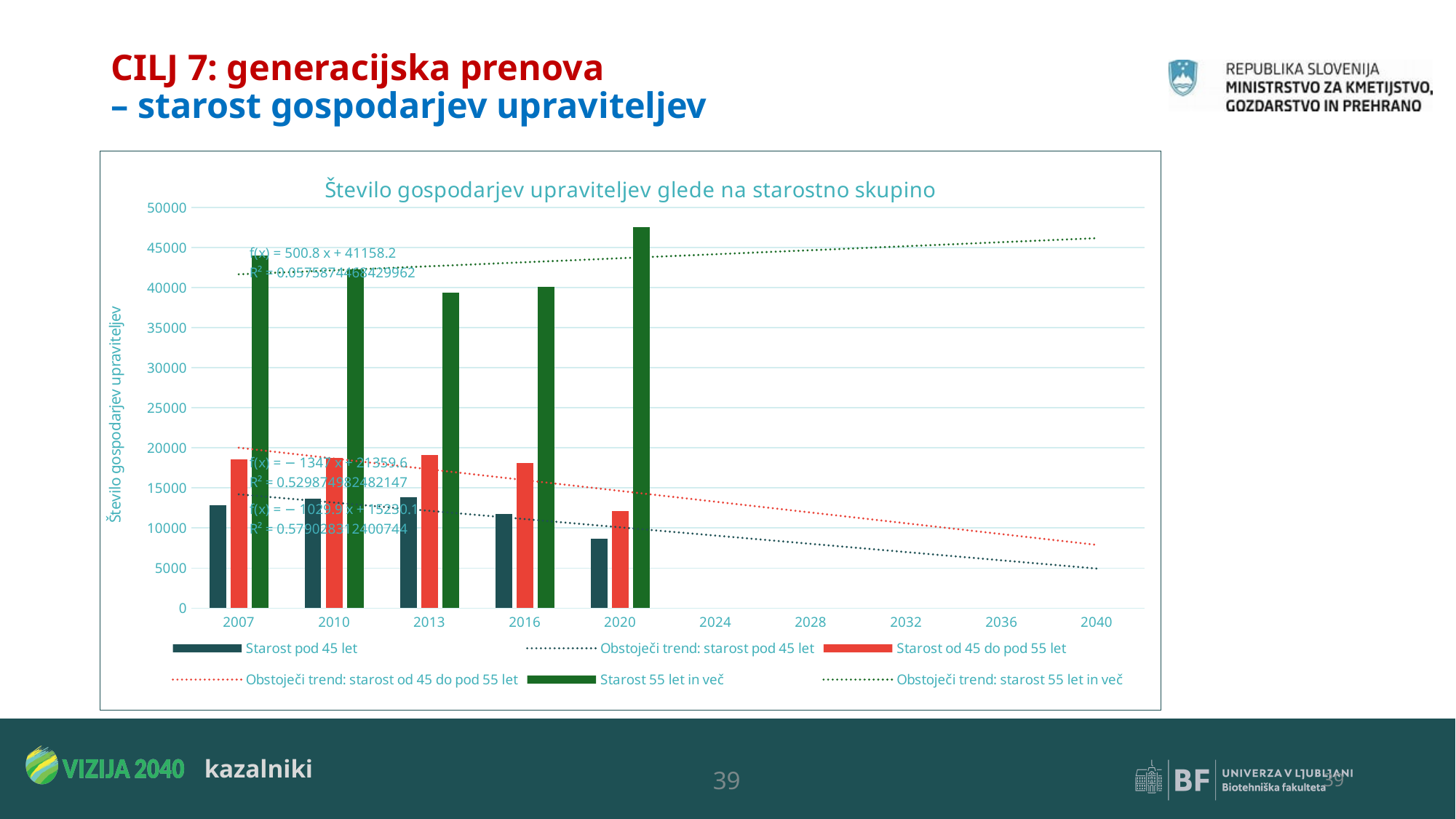
In which year is the bar for 'Starost pod 45 let' the lowest? 2020 Is the value for 'Starost 55 let in več' in 2020 greater or less than 45000? greater What is the title of the chart? Število gospodarjev upraviteljev glede na starostno skupino What kind of chart is shown on the slide? bar chart In which year is the bar for 'Starost od 45 do pod 55 let' the lowest? 2020 Which is larger in 2007: the bar for 'Starost pod 45 let' or the bar for 'Starost od 45 do pod 55 let'? Starost od 45 do pod 55 let For how many years are bars plotted in the chart? 5 Is the value for 'Starost pod 45 let' in 2020 greater or less than 10000? less How many entries does the chart legend list? 6 Does the dotted trend line 'Obstoječi trend: starost 55 let in več' rise or fall from 2007 to 2040? rise Is the value for 'Starost od 45 do pod 55 let' in 2007 greater or less than 20000? less In which year is the bar for 'Starost 55 let in več' the highest? 2020